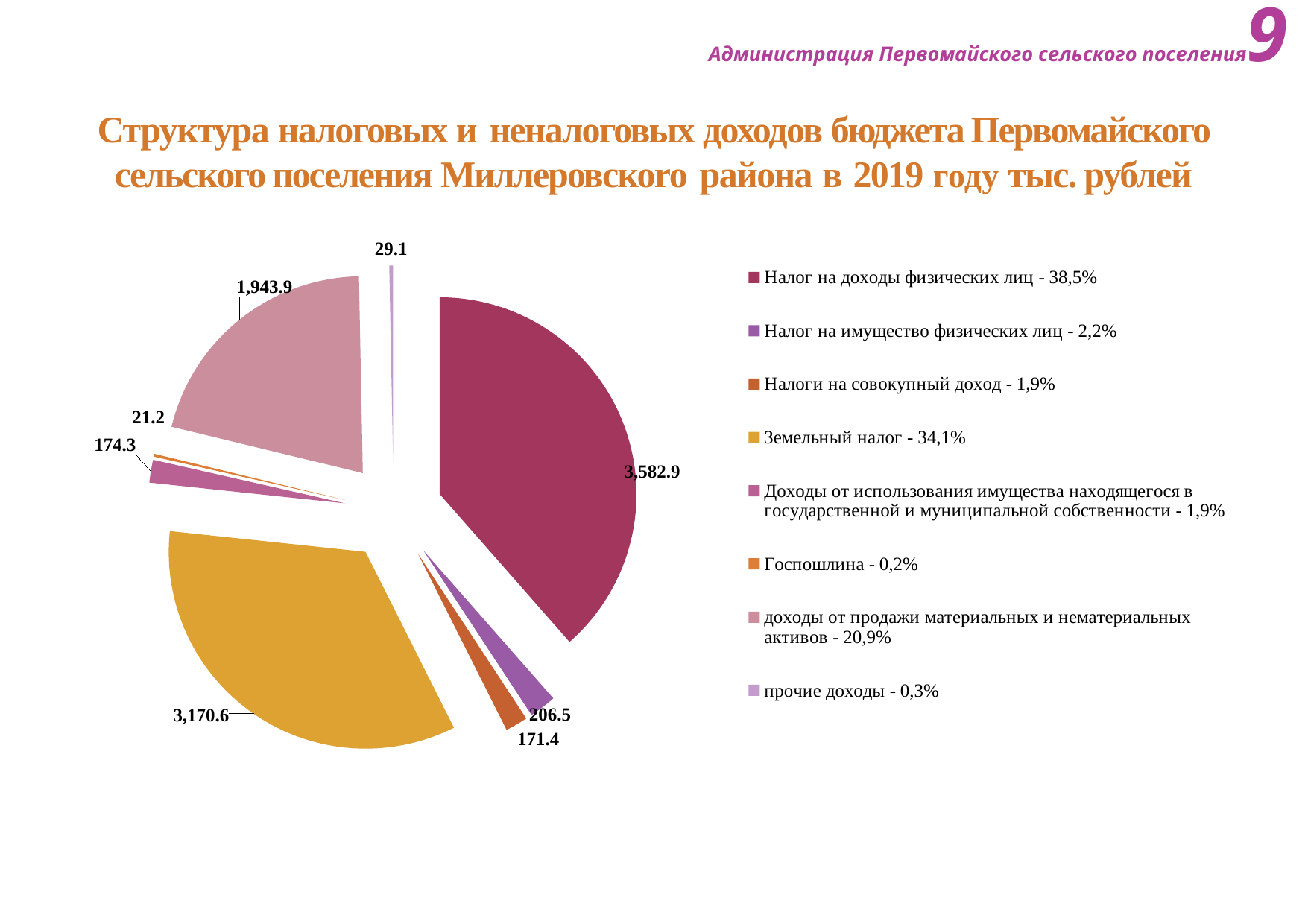
Which is larger: Налог на имущество физических лиц or Налоги на совокупный доход? Налог на имущество физических лиц How many entries does the legend list? 8 What is the difference between Налог на доходы физических лиц and Земельный налог? 412.3 How many slices does the pie chart have? 8 What is the value for Земельный налог? 3,170.6 What kind of chart is shown on the slide? pie chart What is the value for доходы от продажи материальных и нематериальных активов? 1,943.9 What share of the pie does Земельный налог represent, according to the legend? 34,1% Which category has the largest slice? Налог на доходы физических лиц What is the value for Налог на доходы физических лиц? 3,582.9 Which category has the smallest slice? Госпошлина What is the value for Госпошлина? 21.2